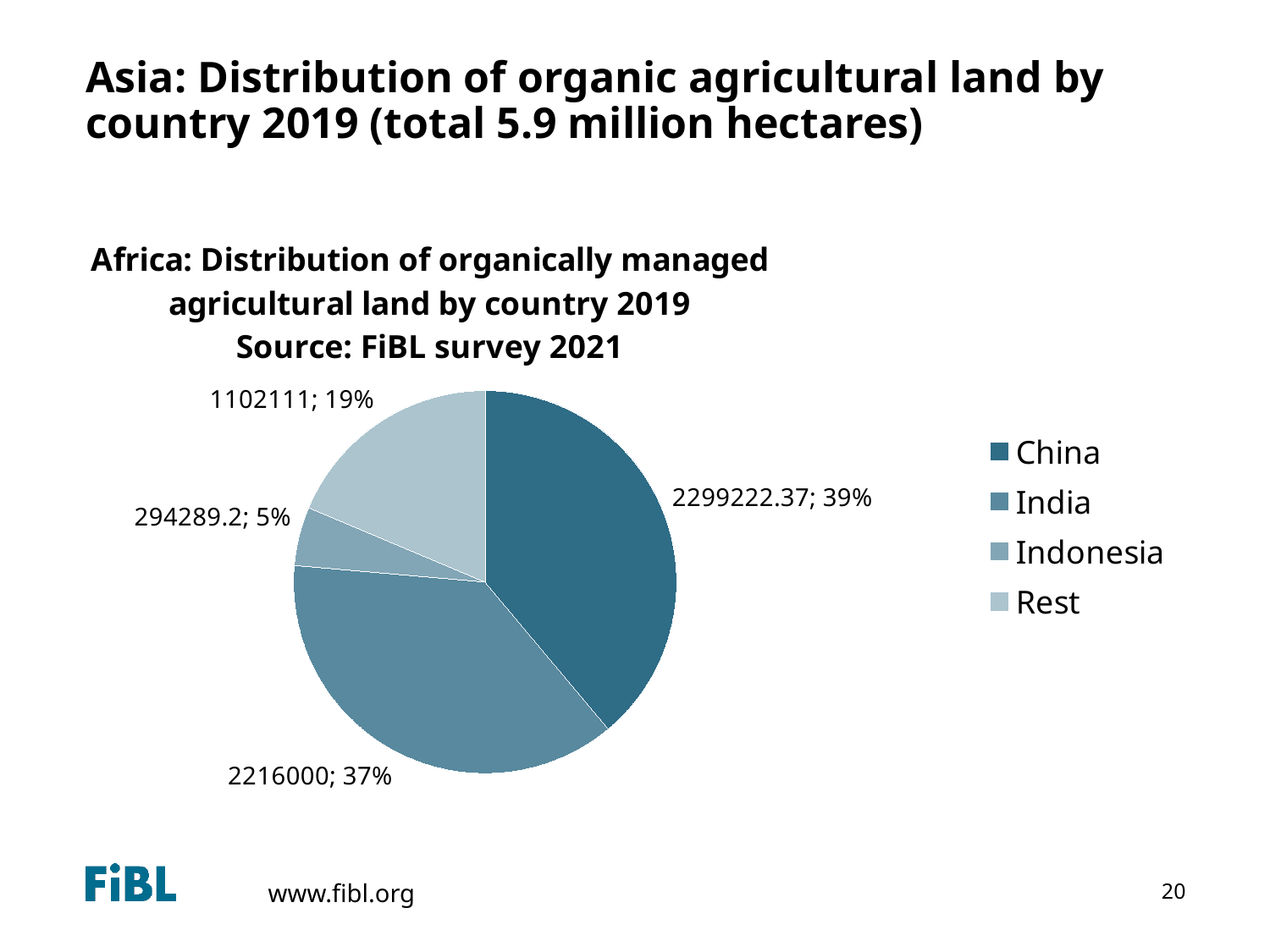
What kind of chart is shown on the slide? pie chart What is the difference in percentage points between the China and India shares? 2 What value is shown for China? 2299222.37 What share of the pie does China account for? 39% Which is larger, the slice for India or the slice for Rest? India What share of the pie does Rest account for? 19% How many entries does the legend list? 4 What value is shown for Indonesia? 294289.2 What value is shown for Rest? 1102111 Which country has the smallest slice? Indonesia How many slices does the pie chart have? 4 What value is shown for India? 2216000